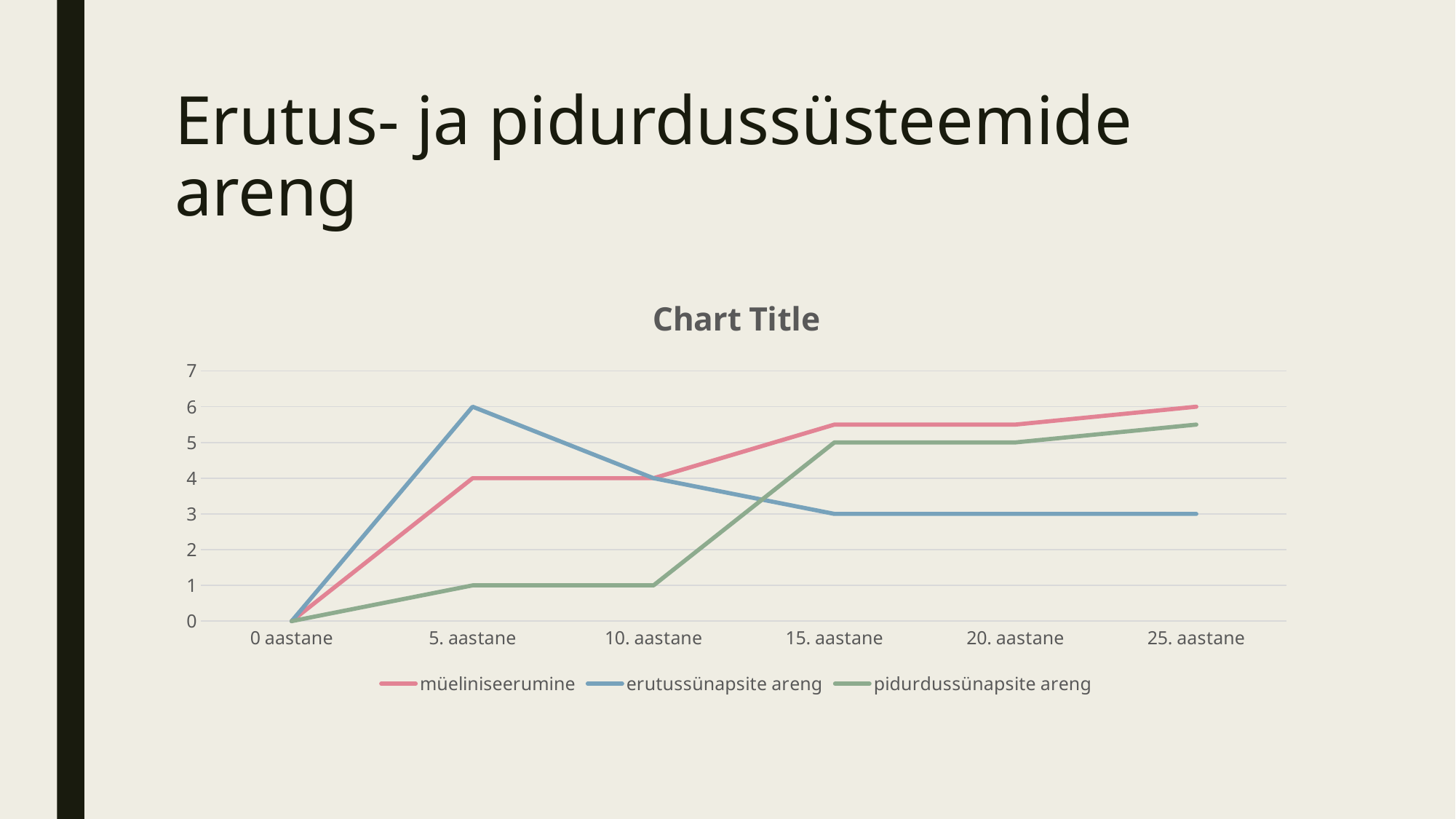
Is the value for müeliniseerumine at 15. aastane greater or less than 5? greater At 10. aastane, what is the difference between müeliniseerumine and pidurdussünapsite areng? 3 Which series has the highest value at 5. aastane? erutussünapsite areng How many categories are shown on the x axis? 6 How many series does the legend list? 3 What is the value of erutussünapsite areng at 5. aastane? 6 Which series has the lowest value at 10. aastane? pidurdussünapsite areng Does the erutussünapsite areng line rise or fall from 5. aastane to 15. aastane? fall What kind of chart is shown on the slide? line chart At 25. aastane, which is larger: müeliniseerumine or erutussünapsite areng? müeliniseerumine What is the value of pidurdussünapsite areng at 15. aastane? 5 What is the title shown above the chart? Chart Title